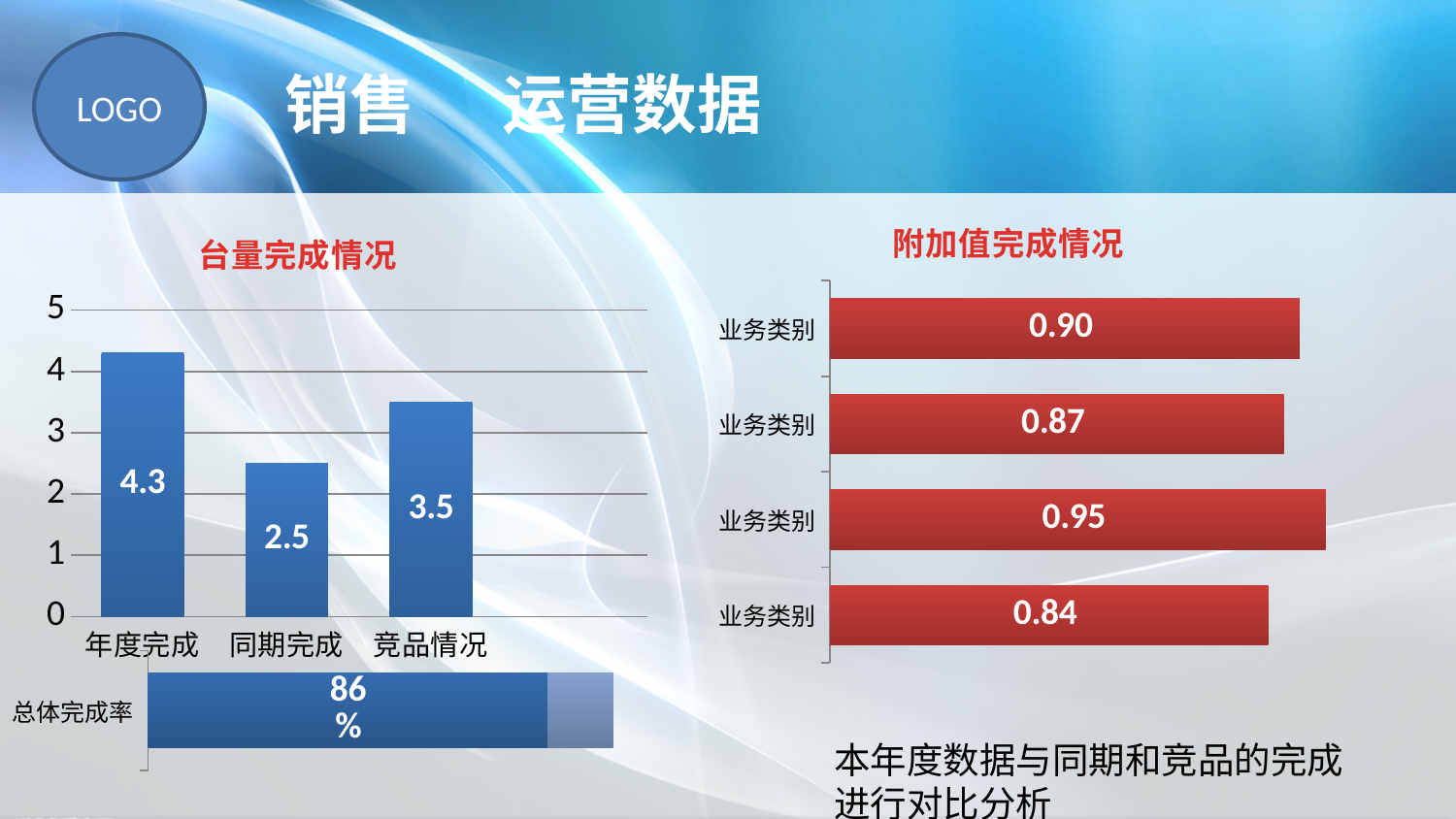
In the 台量完成情况 chart, what is the value for 同期完成? 2.5 In the 附加值完成情况 chart, what is the value of the top bar? 0.90 In the 台量完成情况 chart, which category has the lowest value? 同期完成 What value is shown on the 总体完成率 bar below the 台量完成情况 chart? 86% How many categories are shown in the 台量完成情况 chart? 3 In the 台量完成情况 chart, which category has the highest value? 年度完成 What type of chart is the 附加值完成情况 chart? bar chart In the 附加值完成情况 chart, what is the highest value shown? 0.95 In the 台量完成情况 chart, what is the value for 年度完成? 4.3 In the 台量完成情况 chart, which is larger, 同期完成 or 竞品情况? 竞品情况 In the 附加值完成情况 chart, what is the difference between the third bar (0.95) and the bottom bar (0.84)? 0.11 In the 台量完成情况 chart, what is the difference between 年度完成 and 竞品情况? 0.8